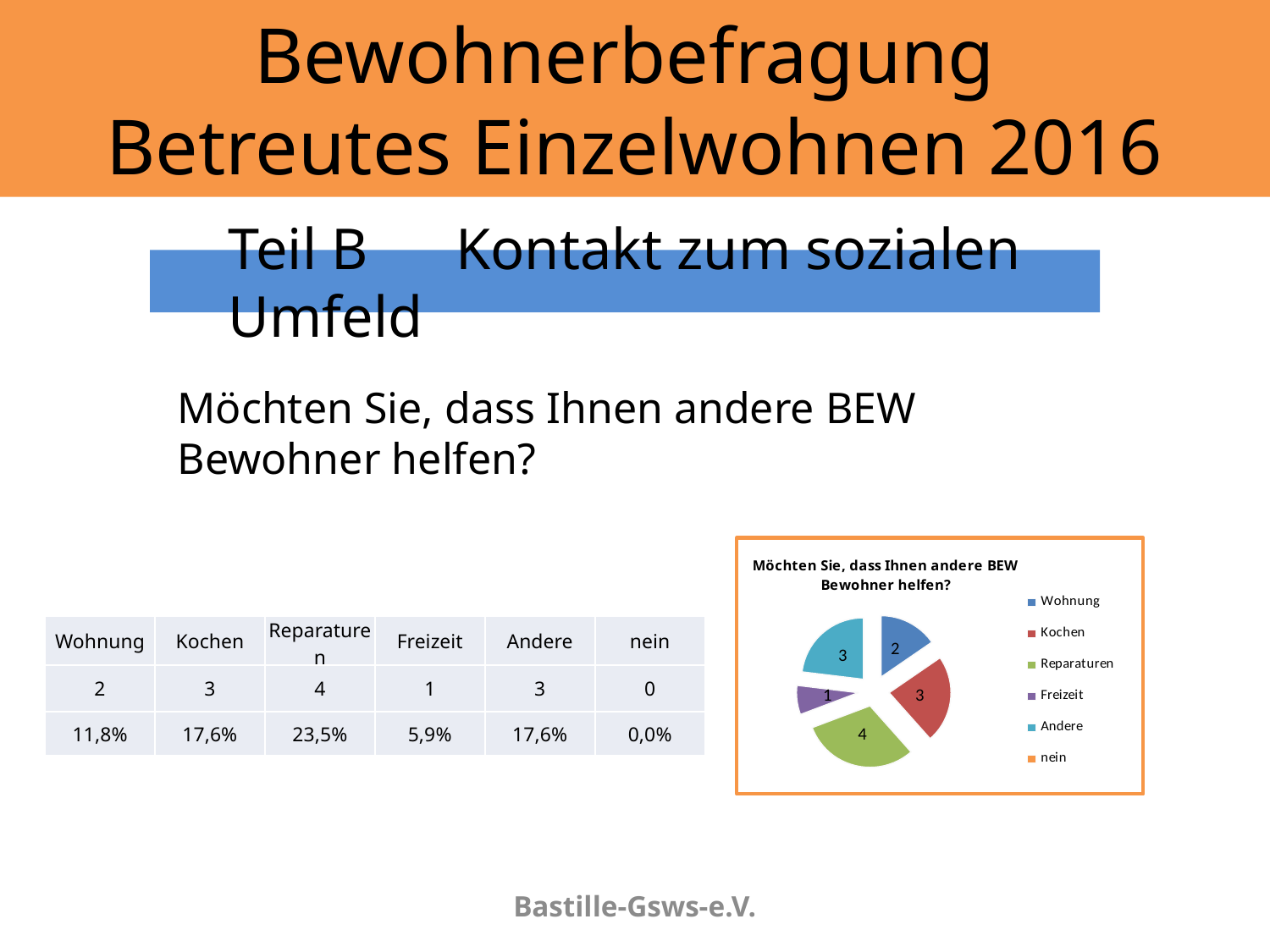
In the pie chart, which is larger, the value for Kochen or the value for Wohnung? Kochen In the pie chart, what is the value for Reparaturen? 4 In the pie chart, what is the value for Andere? 3 In the pie chart, what is the value for Wohnung? 2 What kind of chart is shown on the slide? pie chart In the pie chart, what is the value for Freizeit? 1 How many entries does the legend of the pie chart list? 6 Which category has the smallest visible slice in the pie chart? Freizeit What is the title of the pie chart? Möchten Sie, dass Ihnen andere BEW Bewohner helfen? How many slices with data labels are visible in the pie chart? 5 In the pie chart, what is the difference between the values for Reparaturen and Freizeit? 3 Which category has the largest slice in the pie chart? Reparaturen